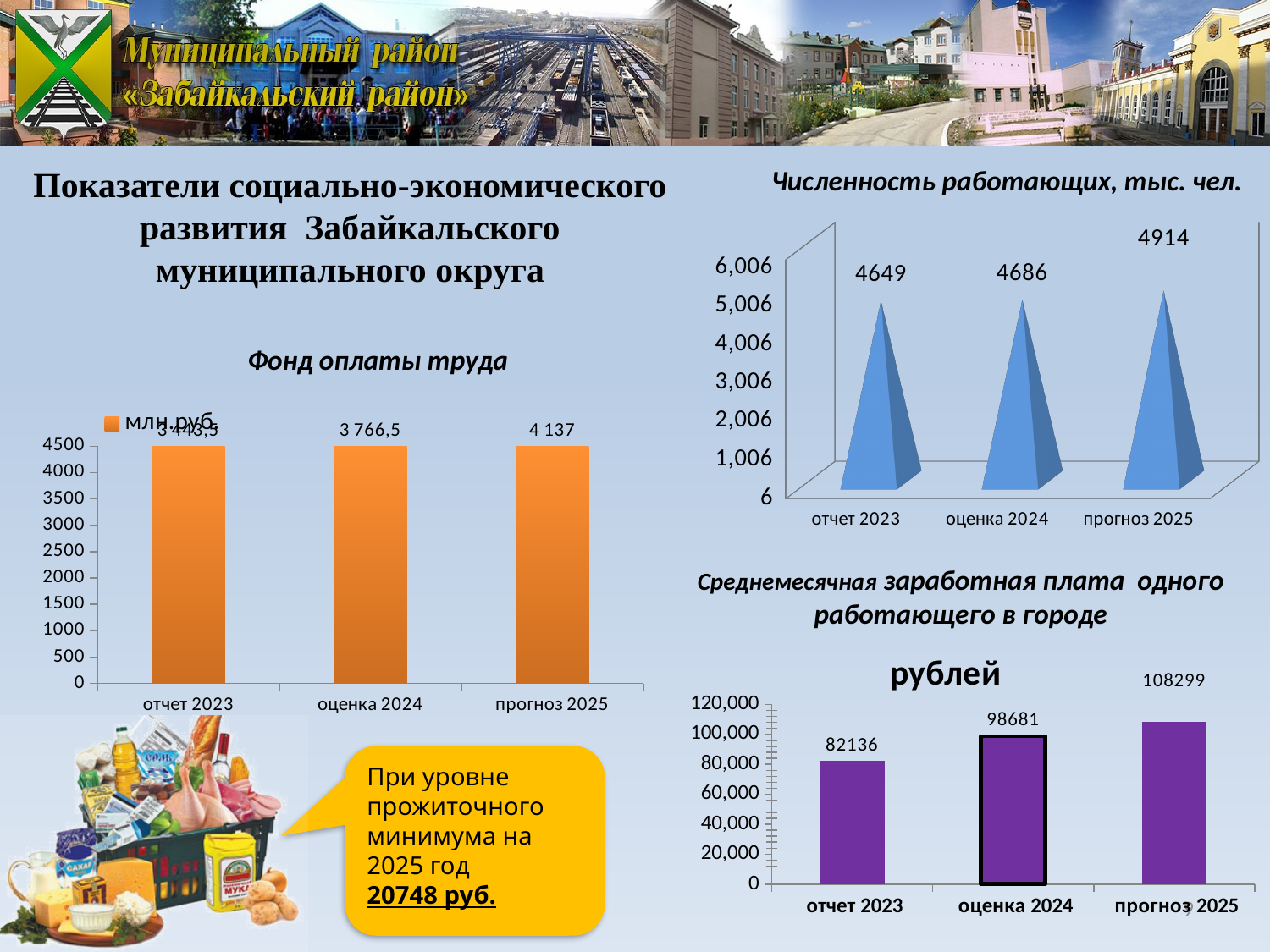
In the chart 'Численность работающих, тыс. чел.', which category has the highest value? прогноз 2025 In the chart 'Численность работающих, тыс. чел.', what is the value for 'отчет 2023'? 4649 In the chart 'Фонд оплаты труда', what series name does the legend show? млн.руб. In the chart 'Среднемесячная заработная плата одного работающего в городе', what is the value for 'прогноз 2025'? 108299 In the chart 'Численность работающих, тыс. чел.', how many categories are shown on the x axis? 3 In the chart 'Среднемесячная заработная плата одного работающего в городе', what is the value for 'оценка 2024'? 98681 In the chart 'Среднемесячная заработная плата одного работающего в городе', which category has the lowest value? отчет 2023 In the chart 'Численность работающих, тыс. чел.', what is the value for 'прогноз 2025'? 4914 In the chart 'Среднемесячная заработная плата одного работающего в городе', what is the difference between 'прогноз 2025' and 'отчет 2023'? 26163 In the chart 'Численность работающих, тыс. чел.', what is the difference between 'прогноз 2025' and 'оценка 2024'? 228 In the chart 'Среднемесячная заработная плата одного работающего в городе', do the values rise or fall from 'отчет 2023' to 'прогноз 2025'? rise In the chart 'Фонд оплаты труда', what is the value for 'прогноз 2025'? 4 137